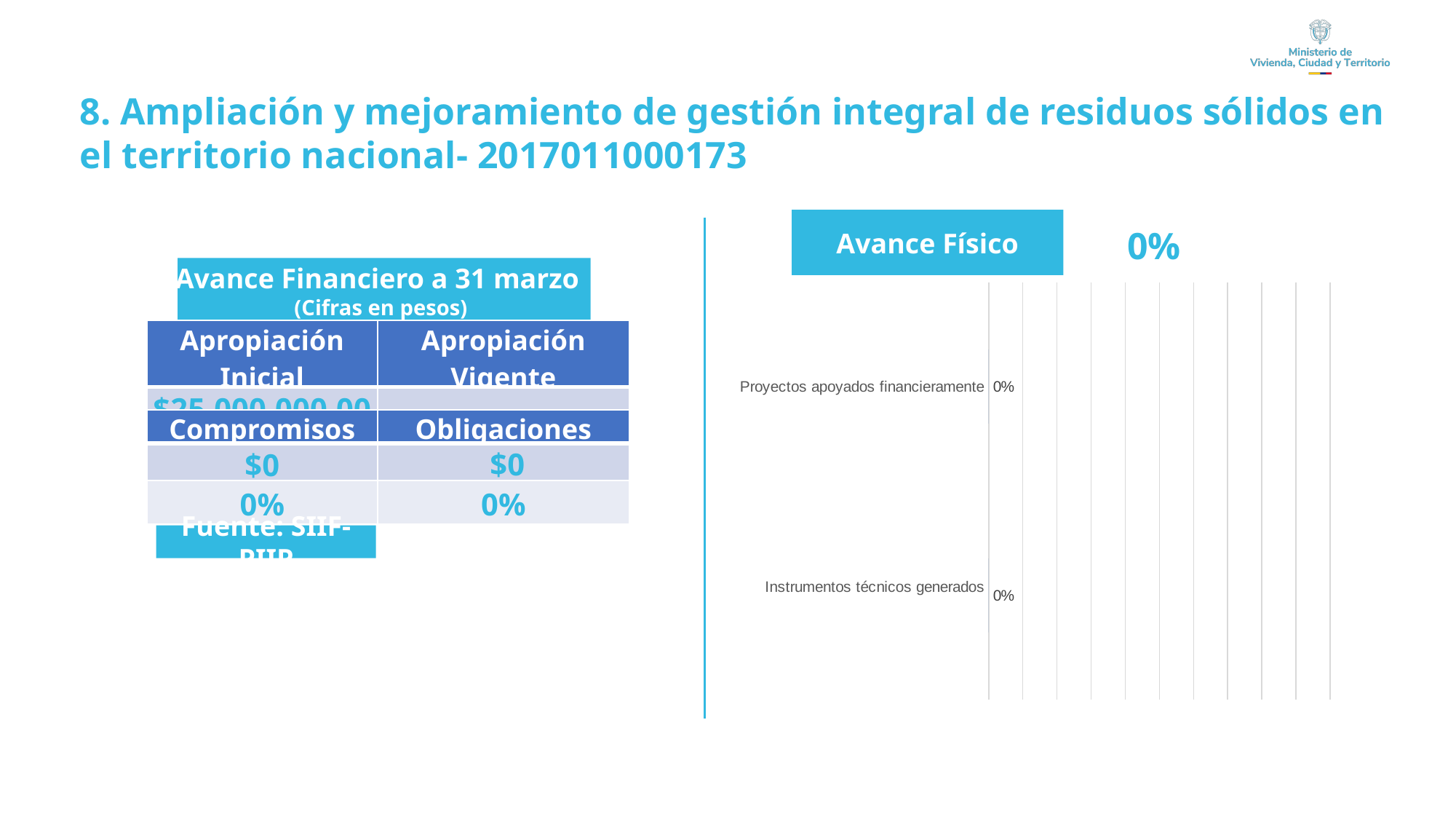
How many categories are shown in the Avance Físico chart? 2 What is the title shown above the chart on the right side of the slide? Avance Físico What is the value for Instrumentos técnicos generados in the Avance Físico chart? 0% What is the value for Proyectos apoyados financieramente in the Avance Físico chart? 0% Which category is listed first (at the top) in the Avance Físico chart? Proyectos apoyados financieramente What is the difference between the values for Proyectos apoyados financieramente and Instrumentos técnicos generados in the Avance Físico chart? 0% What kind of chart is the Avance Físico chart? bar chart